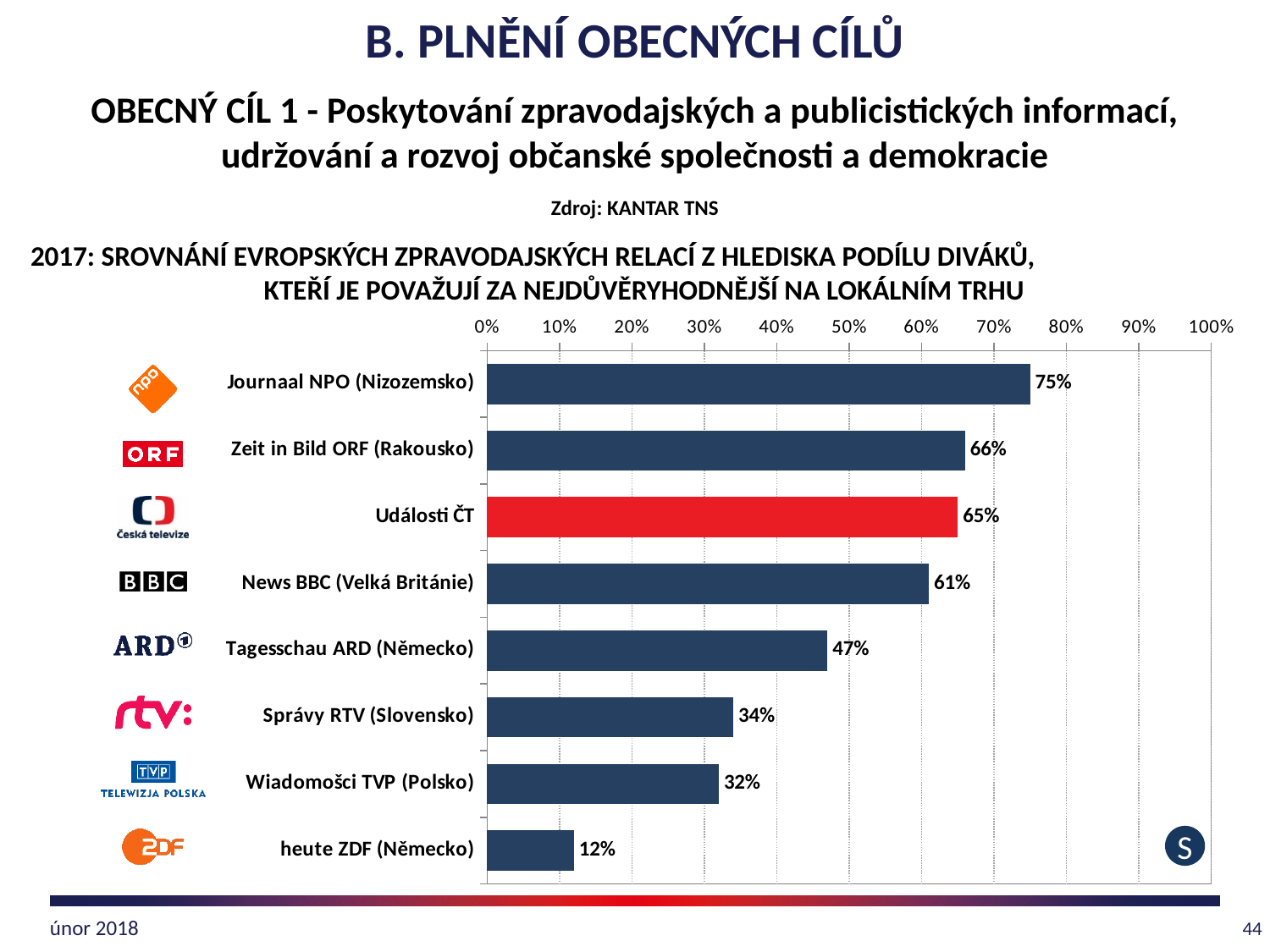
How many news programmes are compared in the chart? 8 What kind of chart is shown on the slide? bar chart Which news programme has the lowest value in the chart? heute ZDF (Německo) What is the value for Tagesschau ARD (Německo)? 47% Is the value for Zeit in Bild ORF (Rakousko) greater or less than 60%? greater What is the difference between the values for Journaal NPO (Nizozemsko) and News BBC (Velká Británie)? 14% Which has a larger value, Správy RTV (Slovensko) or Tagesschau ARD (Německo)? Tagesschau ARD (Německo) What is the source of the data cited on the slide? KANTAR TNS What is the value for Události ČT? 65% What is the value for Wiadomošci TVP (Polsko)? 32% Which bar is highlighted in red? Události ČT Which news programme has the highest share of viewers considering it most trustworthy? Journaal NPO (Nizozemsko)